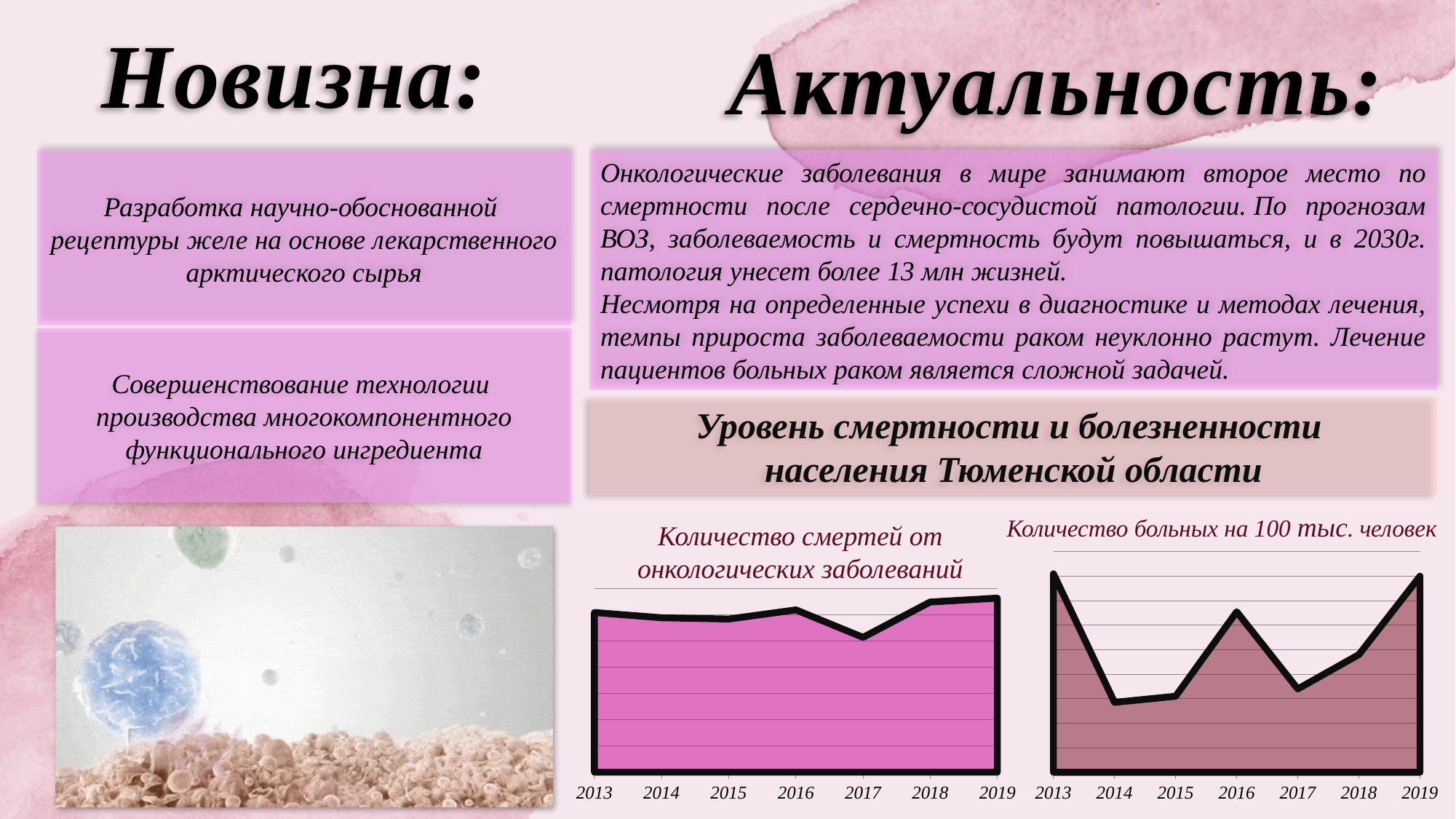
What kind of chart is the chart titled "Количество больных на 100 тыс. человек"? area chart In the chart "Количество смертей от онкологических заболеваний", do the values rise or fall from 2017 to 2018? rise What is the first year shown on the x axis of the chart "Количество больных на 100 тыс. человек"? 2013 In the chart "Количество больных на 100 тыс. человек", which year has the lowest value? 2014 How many years are shown on the x axis of the chart "Количество смертей от онкологических заболеваний"? 7 In the chart "Количество больных на 100 тыс. человек", do the values rise or fall from 2017 to 2019? rise In the chart "Количество смертей от онкологических заболеваний", which year has the lowest value? 2017 What kind of chart is the chart titled "Количество смертей от онкологических заболеваний"? area chart In the chart "Количество смертей от онкологических заболеваний", which is larger, the value for 2017 or the value for 2019? 2019 How many years are shown on the x axis of the chart "Количество больных на 100 тыс. человек"? 7 In the chart "Количество больных на 100 тыс. человек", which is larger, the value for 2014 or the value for 2016? 2016 In the chart "Количество больных на 100 тыс. человек", which is larger, the value for 2016 or the value for 2017? 2016